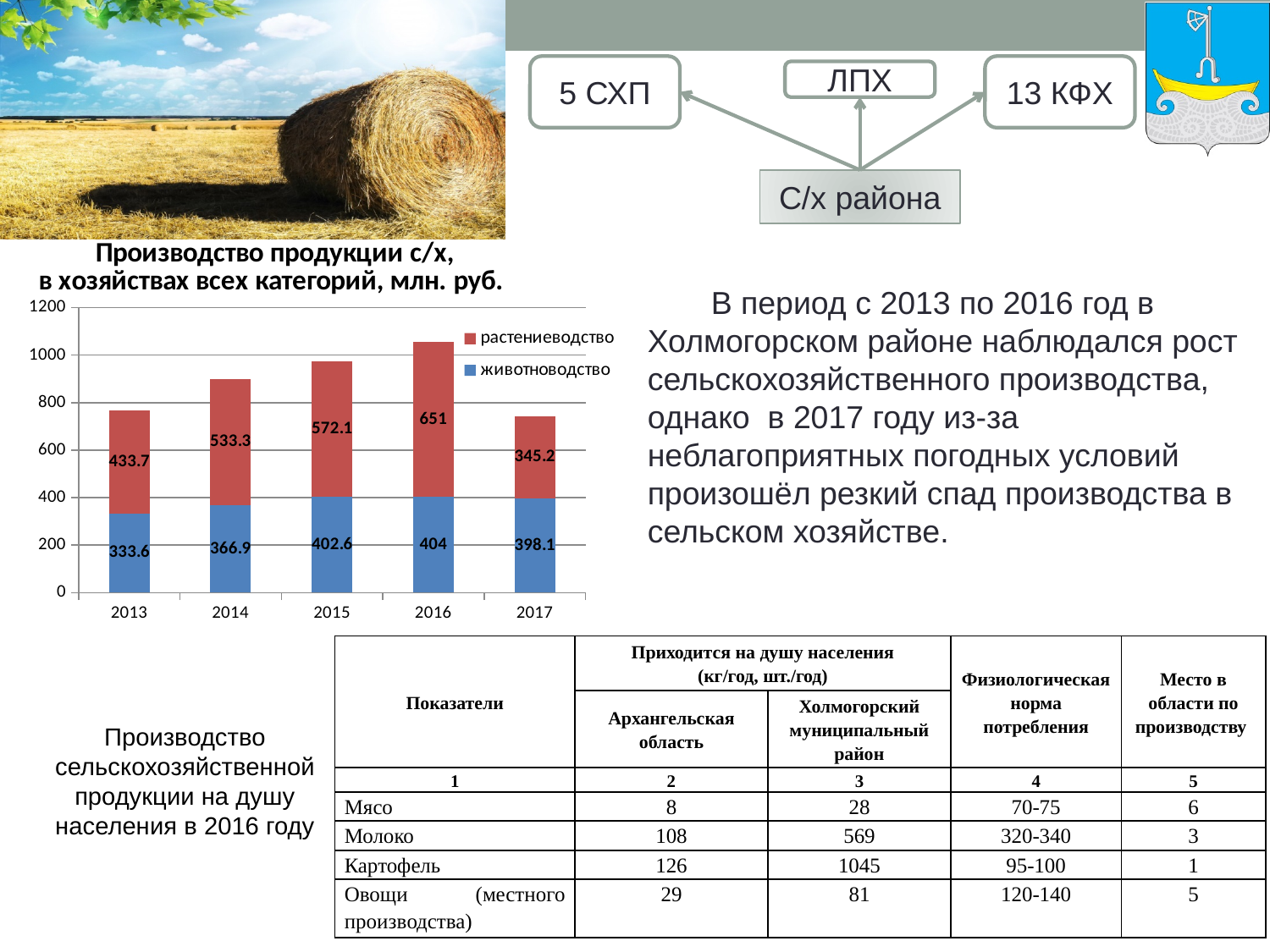
What kind of chart is shown on the slide? stacked bar chart How many series does the legend list? 2 What is the total of the stacked bar for 2016? 1055 Which is larger in 2017: растениеводство or животноводство? животноводство What is the value for растениеводство in 2016? 651 In which year is the животноводство value lowest? 2013 What is the difference between the растениеводство values for 2016 and 2017? 305.8 What is the value for животноводство in 2013? 333.6 In which year is the растениеводство value highest? 2016 What is the total of the stacked bar for 2013? 767.3 What is the value for растениеводство in 2017? 345.2 How many years are shown on the x axis? 5